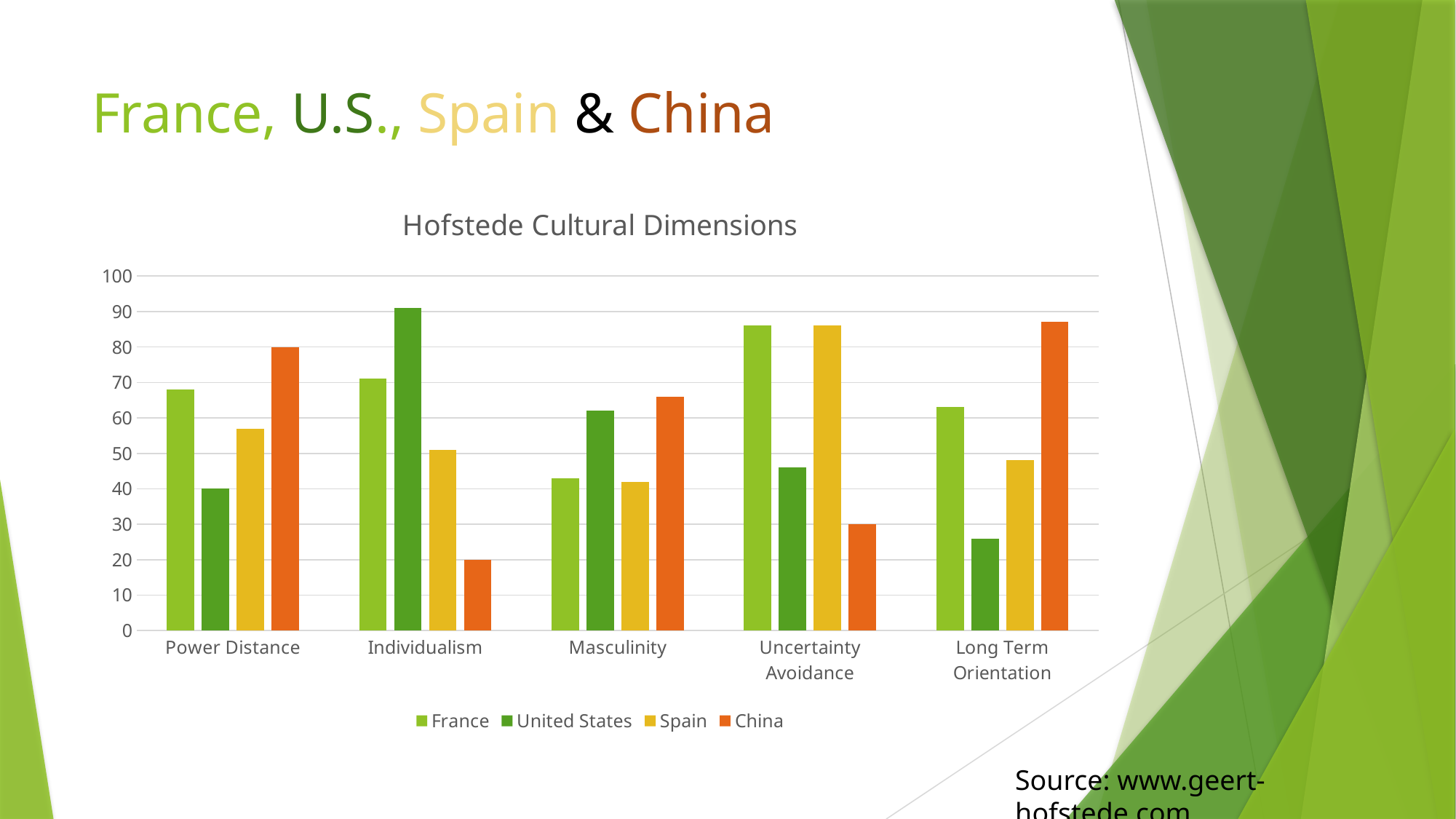
Which country has the highest value for Long Term Orientation? China Is the value for United States in Uncertainty Avoidance greater or less than 50? less Is the value for Spain in Power Distance greater or less than 50? greater Which country has the highest value for Individualism? United States Which country has the highest value for Power Distance? China Which country has the lowest value for Uncertainty Avoidance? China Which country has the lowest value for Individualism? China For Power Distance, which is larger: the value for France or the value for Spain? France How many series does the legend list? 4 What is the title of the chart? Hofstede Cultural Dimensions How many categories are shown on the x axis? 5 What type of chart is shown on the slide? bar chart